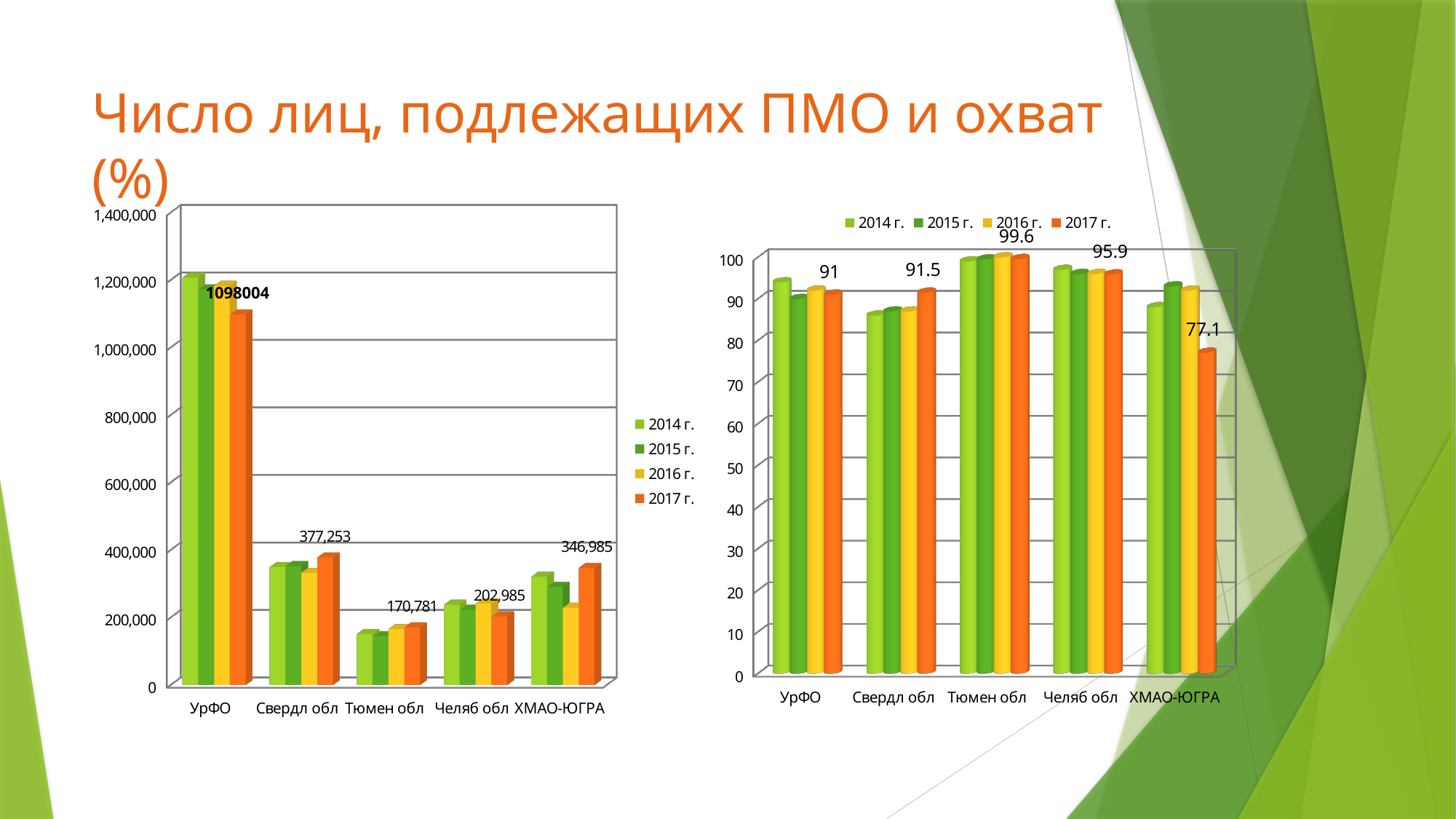
On the left chart, what is the 2017 value for Свердл обл? 377,253 On the left chart, is the 2014 value for УрФО greater or less than 1,000,000? greater On the left chart, what is the 2017 value for Тюмен обл? 170,781 On the right chart, which is larger: the 2017 value for Челяб обл or for УрФО? Челяб обл On the left chart, what is the labelled 2017 value for УрФО? 1098004 How many series does the legend of the right chart list? 4 On the right chart, what is the 2017 value for Тюмен обл? 99.6 On the left chart, what is the 2017 value for ХМАО-ЮГРА? 346,985 On the left chart, what is the difference between the 2017 values for Свердл обл and Челяб обл? 174,268 On the right chart, what is the 2017 value for ХМАО-ЮГРА? 77.1 On the right chart, which category has the lowest 2017 value? ХМАО-ЮГРА On the left chart, which category has the highest values? УрФО